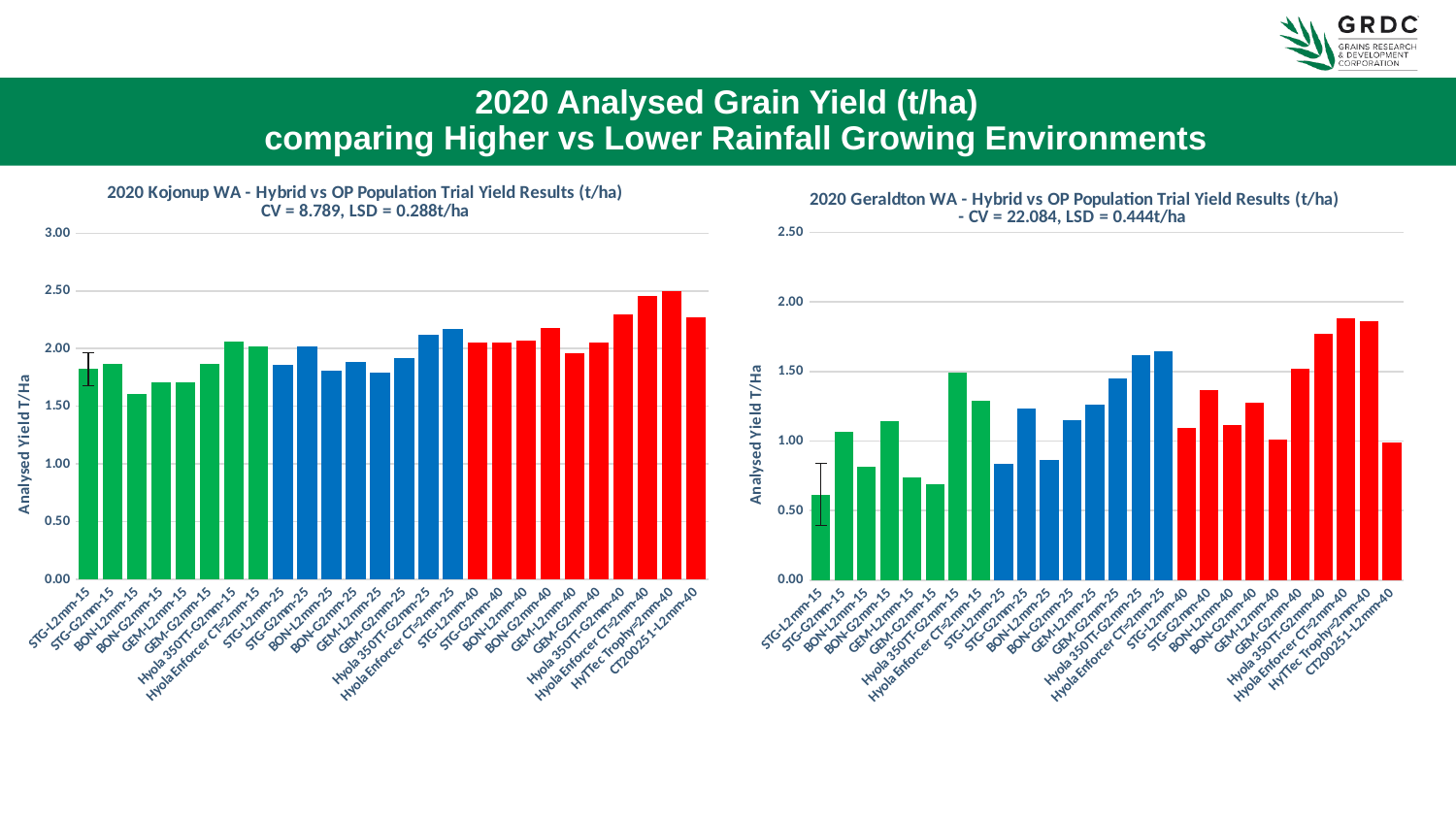
In the 2020 Kojonup WA chart, which is larger: the value for Hyola Enforcer CT-2mm-25 or the value for STG-L2mm-25? Hyola Enforcer CT-2mm-25 How many bars are plotted in the 2020 Geraldton WA chart on the right? 26 In the 2020 Geraldton WA chart, which is larger: the value for Hyola 350TT-G2mm-15 or the value for STG-L2mm-15? Hyola 350TT-G2mm-15 In the 2020 Kojonup WA chart, which category has the lowest analysed yield? BON-L2mm-15 What LSD value is stated in the title of the 2020 Geraldton WA chart? 0.444t/ha What kind of chart is the 2020 Kojonup WA chart on the left? bar chart In the 2020 Geraldton WA chart, is the value for Hyola Enforcer CT-2mm-25 greater or less than 1.50? greater In the 2020 Kojonup WA chart, is the value for Hyola 350TT-G2mm-15 greater or less than 2.00? greater In the 2020 Geraldton WA chart, which category has the lowest analysed yield? STG-L2mm-15 In the 2020 Geraldton WA chart, is the value for STG-L2mm-25 greater or less than 1.00? less What CV value is stated in the title of the 2020 Kojonup WA chart? 8.789